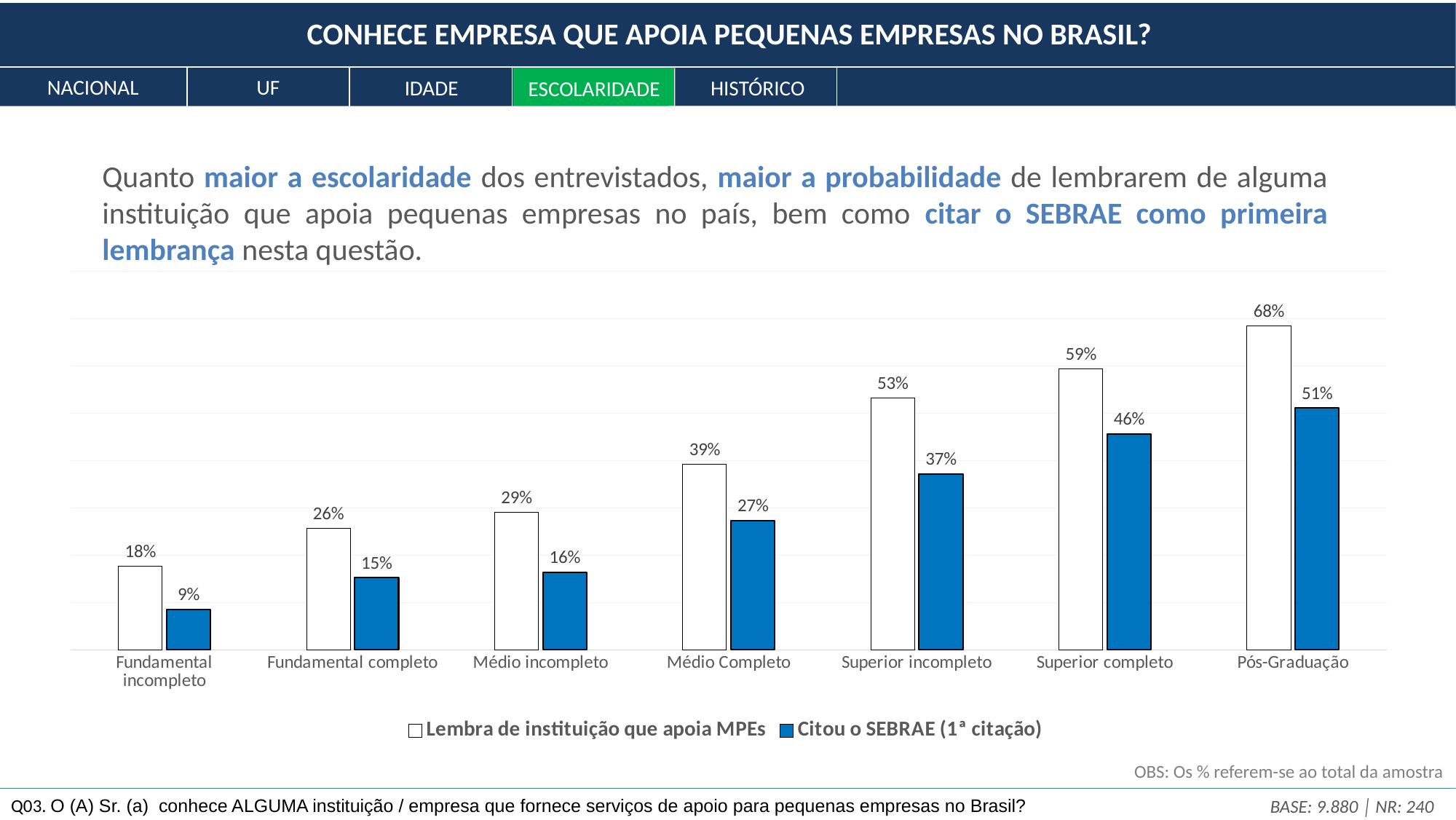
Which category has the highest value for "Lembra de instituição que apoia MPEs"? Pós-Graduação What kind of chart is shown on the slide? Bar chart Which series is shown with blue filled bars? Citou o SEBRAE (1ª citação) How many education categories are shown on the x axis? 7 What is the value of "Citou o SEBRAE (1ª citação)" for Médio Completo? 27% What is the difference between "Lembra de instituição que apoia MPEs" and "Citou o SEBRAE (1ª citação)" for Superior completo? 13% What is the value of "Citou o SEBRAE (1ª citação)" for Fundamental incompleto? 9% What is the value of "Lembra de instituição que apoia MPEs" for Pós-Graduação? 68% How many series does the legend list? 2 Which is larger: "Citou o SEBRAE (1ª citação)" for Superior incompleto or "Lembra de instituição que apoia MPEs" for Médio incompleto? Citou o SEBRAE (1ª citação) for Superior incompleto Do the values for "Lembra de instituição que apoia MPEs" rise or fall from Fundamental incompleto to Pós-Graduação? Rise Which category has the lowest value for "Citou o SEBRAE (1ª citação)"? Fundamental incompleto